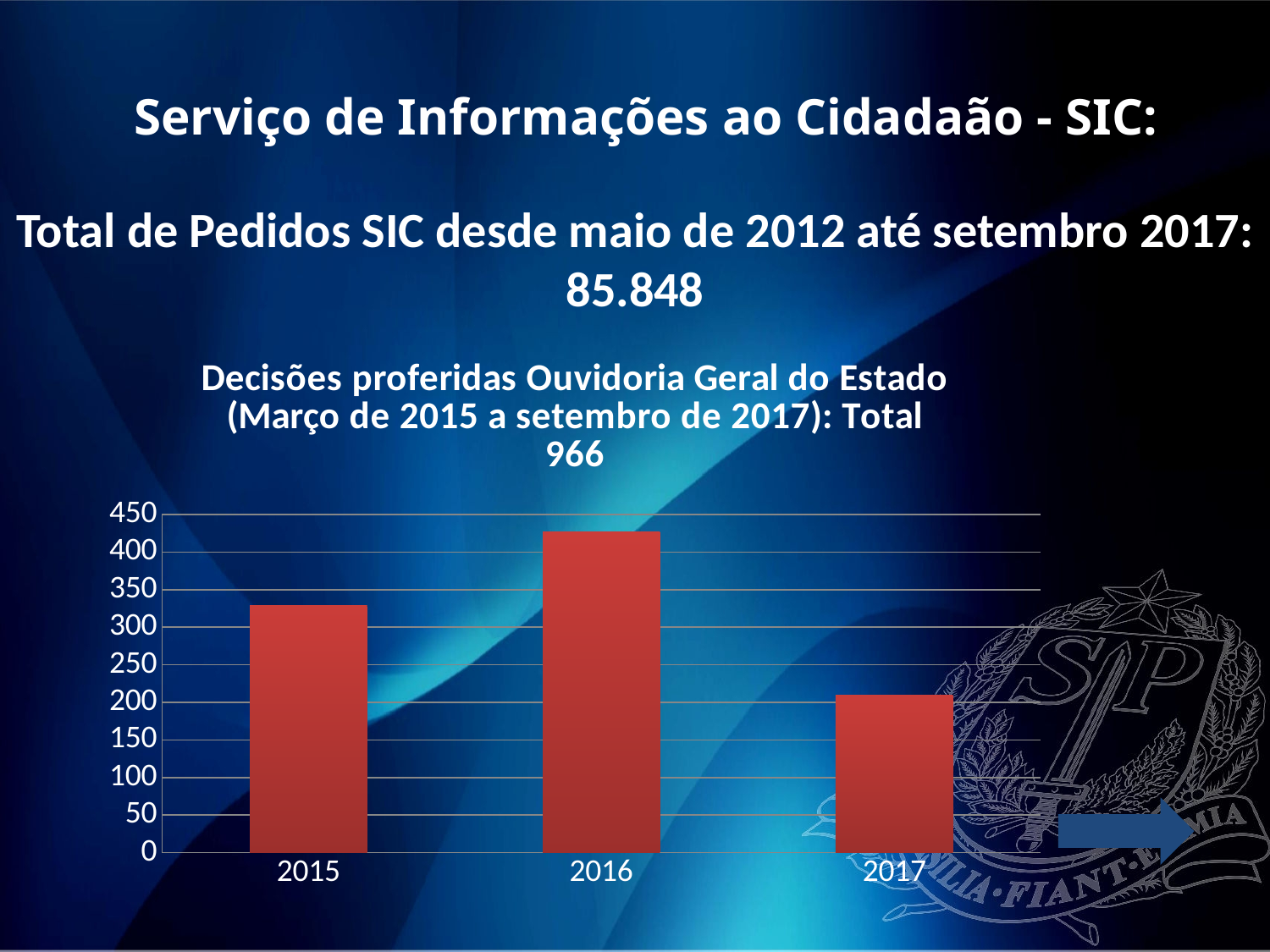
Which year has the larger value, 2015 or 2017? 2015 What kind of chart is shown on the slide? bar chart Is the value for 2017 greater or less than 250? less Which year has the highest bar in the chart? 2016 Is the value for 2015 greater or less than 300? greater Which year has the lowest bar in the chart? 2017 Do the values rise or fall from 2016 to 2017? fall Is the value for 2016 greater or less than 400? greater What is the highest value shown on the chart's vertical axis? 450 What total is stated in the chart title for decisions issued from March 2015 to September 2017? 966 Which year has the larger value, 2015 or 2016? 2016 How many years are shown on the x axis of the chart? 3